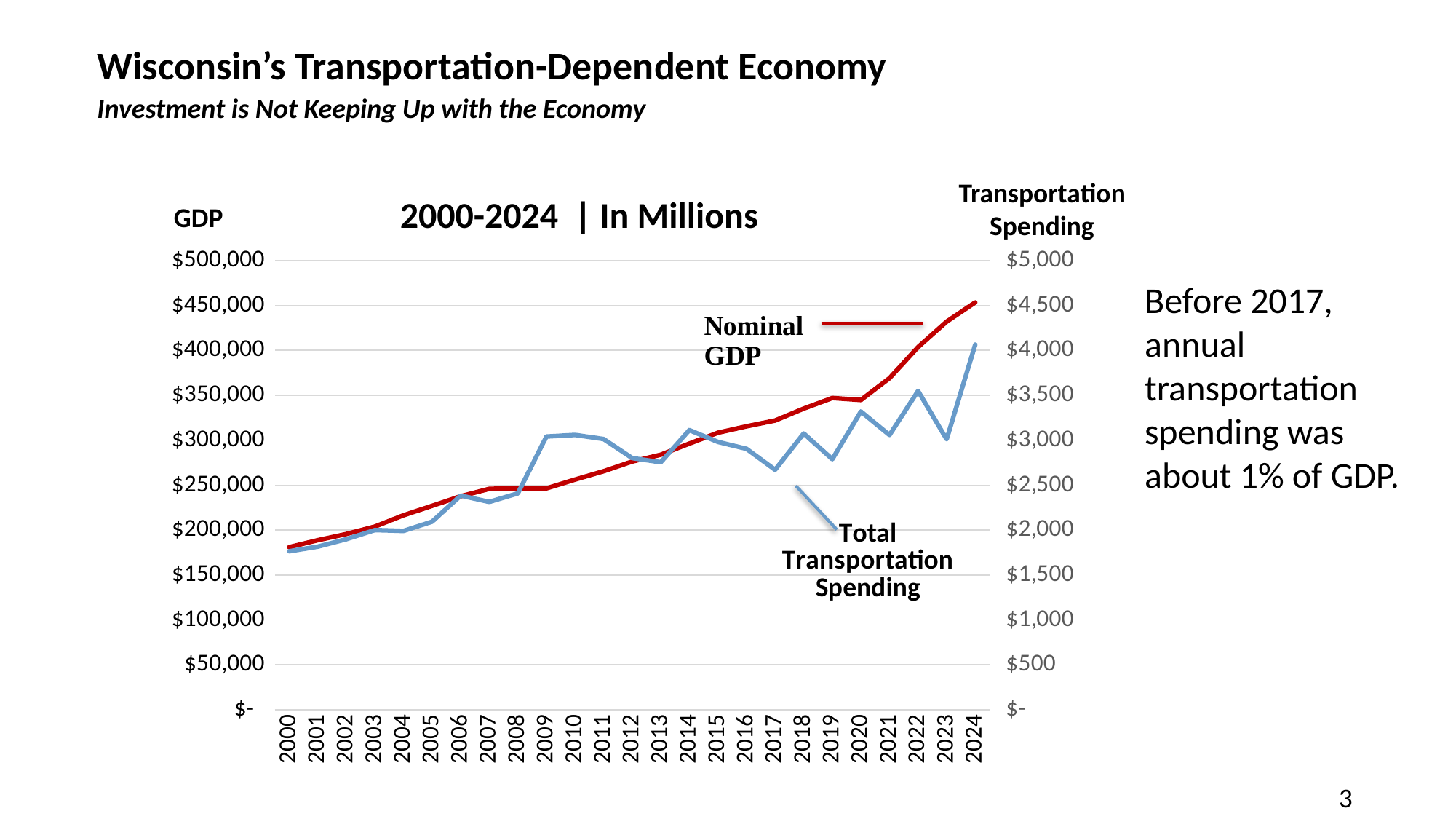
How many years are shown along the x axis of the chart? 25 Which series is plotted against the right-hand axis labelled Transportation Spending? Total Transportation Spending How many data series are plotted on the chart? 2 Is the Total Transportation Spending value for 2017 greater or less than $3,000? less Is the Total Transportation Spending value for 2024 greater or less than $3,500? greater What is the title of the chart? 2000-2024 | In Millions Is the Nominal GDP value for 2024 greater or less than $400,000? greater What kind of chart is shown on the slide? Line chart In which year is Total Transportation Spending highest? 2024 Does Nominal GDP generally rise or fall from 2000 to 2024? Rise Which year has the higher Total Transportation Spending, 2022 or 2023? 2022